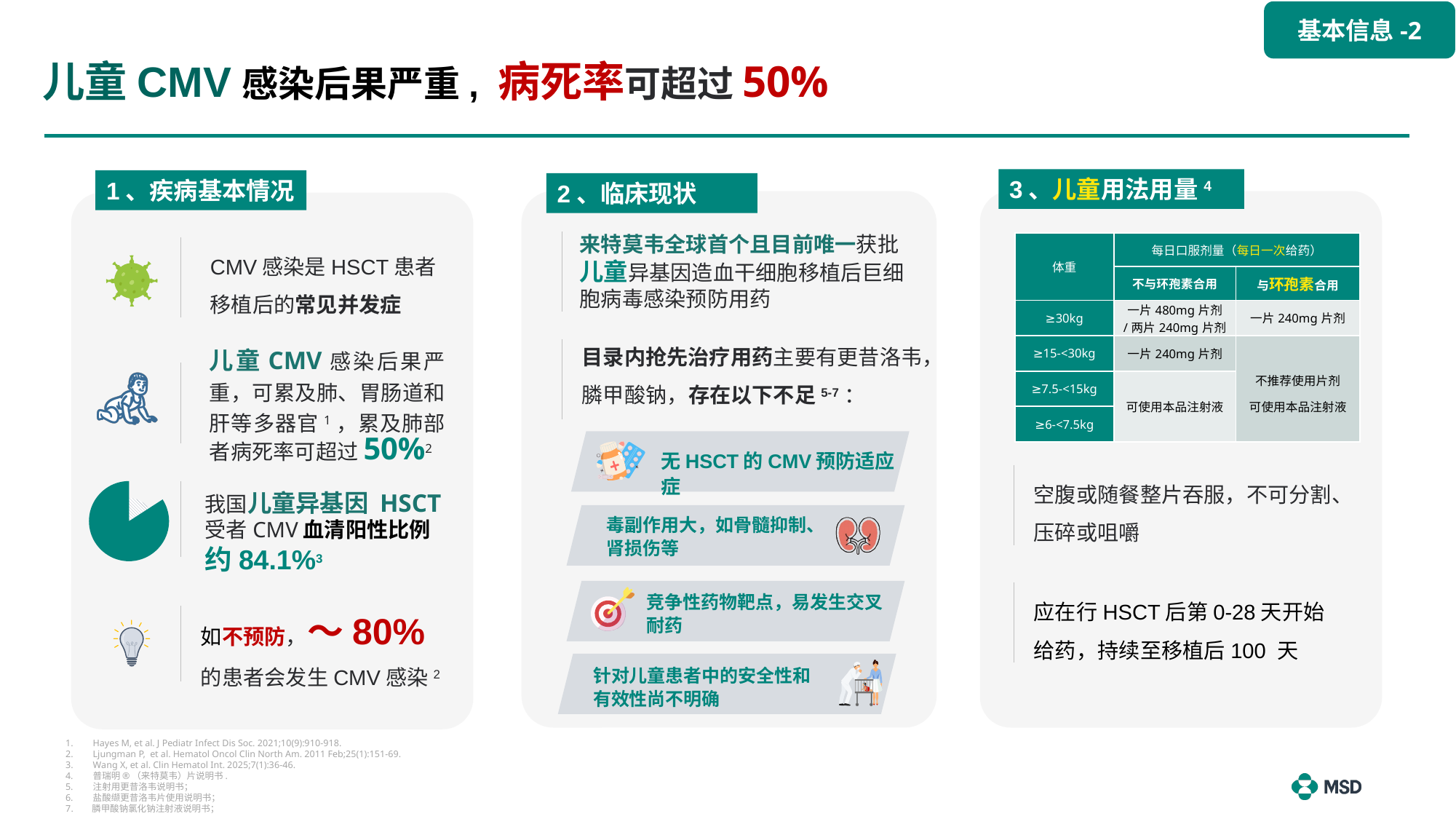
What colour is the large segment of the pie graphic in section 1? teal (green) According to the pie graphic in section 1, what share of pediatric allogeneic HSCT recipients in China are CMV seropositive? 约 84.1% Is the CMV seropositive share shown by the pie graphic in section 1 greater or less than 50%? greater How many segments does the pie graphic in section 1 show? 2 What kind of chart is the graphic next to the text about CMV seropositivity in section 1? pie chart